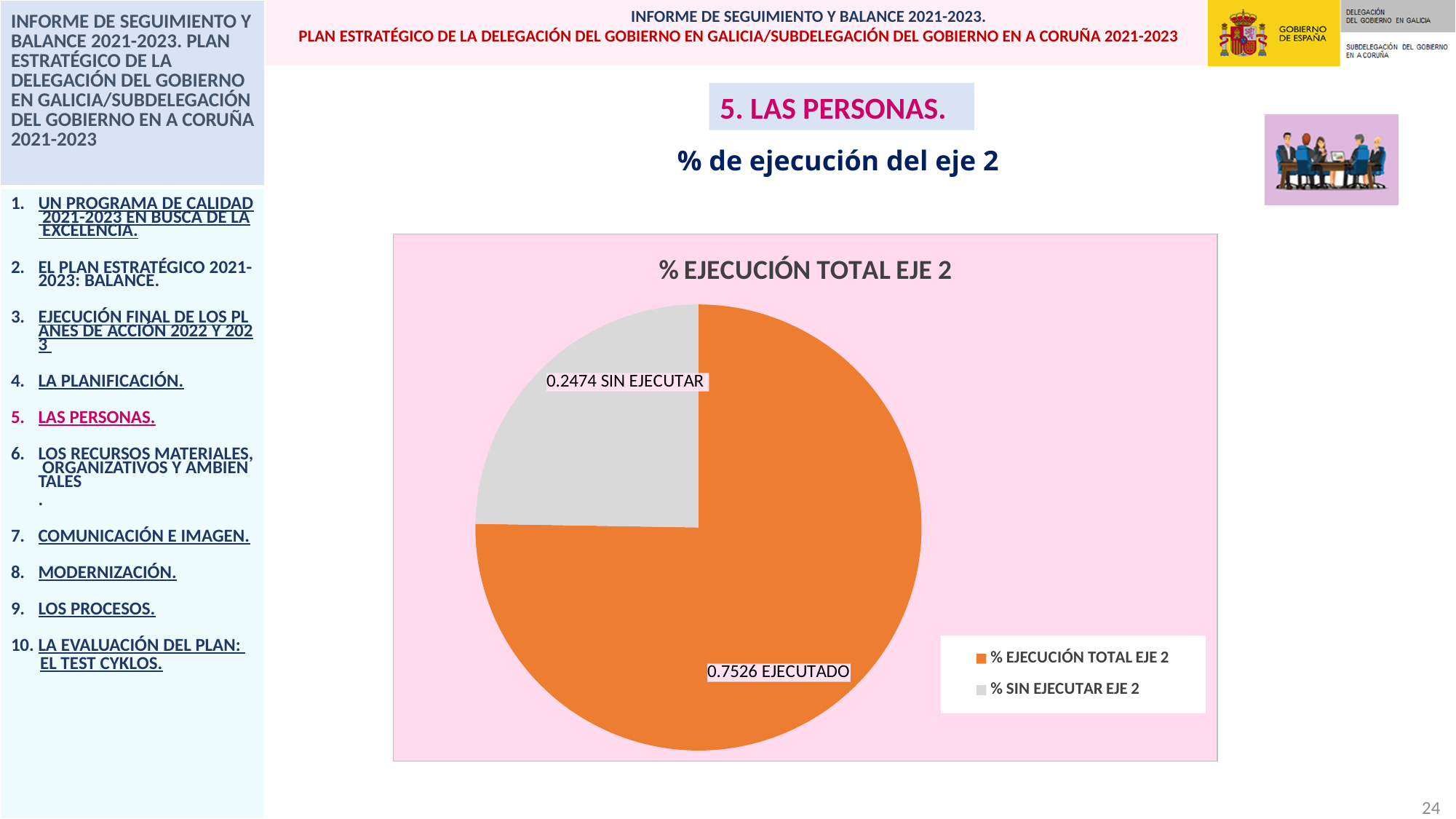
What is the total of the two slice values shown in the pie chart? 1 How many entries does the legend list? 2 What value is shown for the EJECUTADO slice? 0.7526 Which slice is the smallest in the pie chart? SIN EJECUTAR (% SIN EJECUTAR EJE 2) How many slices does the pie chart have? 2 What is the difference between the EJECUTADO value and the SIN EJECUTAR value? 0.5052 What is the title of the chart? % EJECUCIÓN TOTAL EJE 2 Which slice is the largest in the pie chart? EJECUTADO (% EJECUCIÓN TOTAL EJE 2) What colour is the % EJECUCIÓN TOTAL EJE 2 slice? orange What kind of chart is shown on the slide? pie chart What value is shown for the SIN EJECUTAR slice? 0.2474 Which is larger, the EJECUTADO slice or the SIN EJECUTAR slice? EJECUTADO